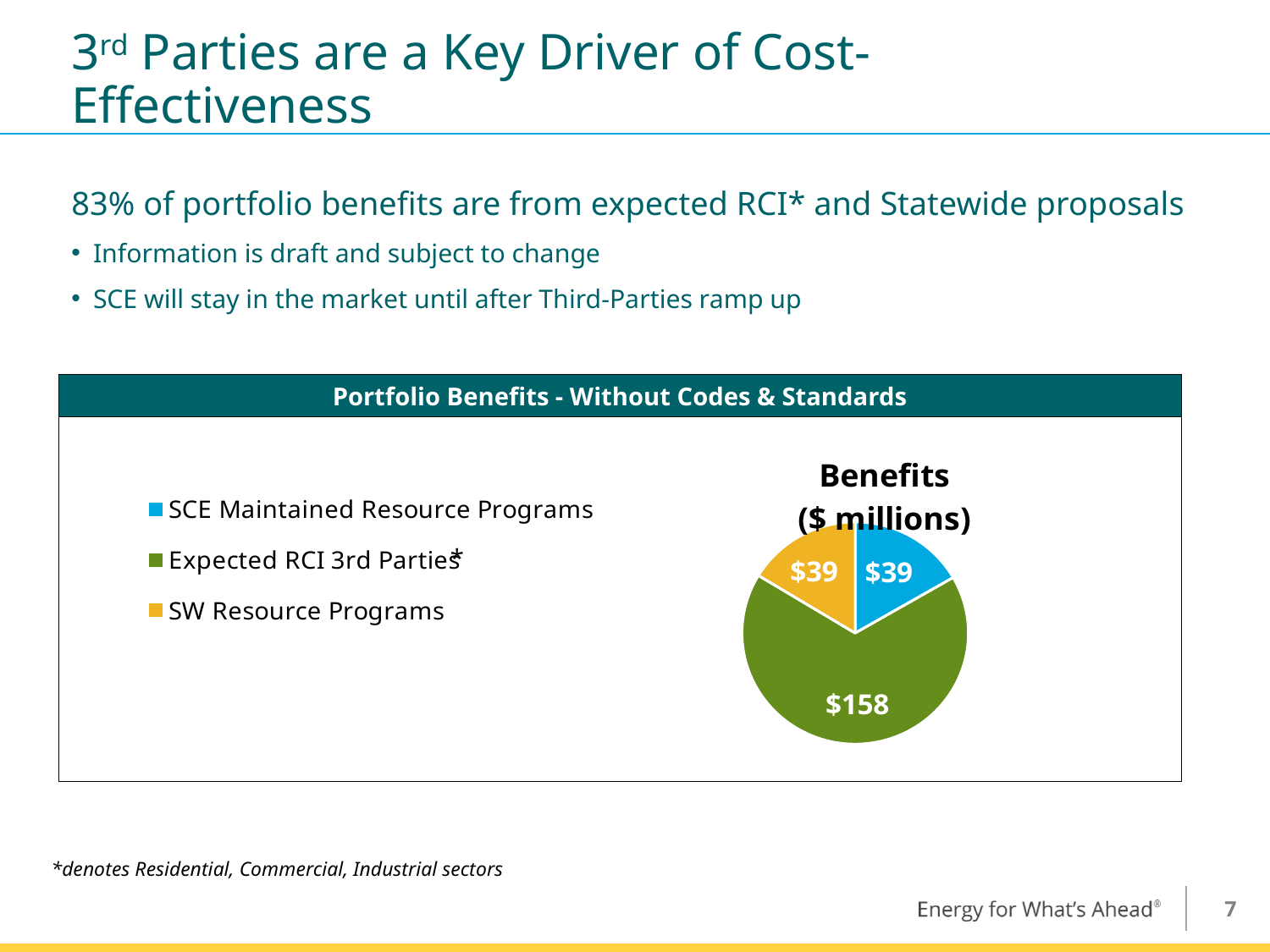
What is the difference between the Expected RCI 3rd Parties value and the SCE Maintained Resource Programs value? $119 What is the value for SW Resource Programs in the pie chart? $39 What is the title of the pie chart? Benefits ($ millions) What is the value for Expected RCI 3rd Parties in the Benefits ($ millions) pie chart? $158 What kind of chart is shown on the slide? Pie chart How many slices does the Benefits ($ millions) pie chart have? 3 How many entries does the legend of the pie chart list? 3 Which category has the largest slice in the Benefits ($ millions) pie chart? Expected RCI 3rd Parties Which is larger, the value for Expected RCI 3rd Parties or the value for SW Resource Programs? Expected RCI 3rd Parties What is the value for SCE Maintained Resource Programs in the pie chart? $39 What is the total of all slices in the Benefits ($ millions) pie chart? $236 What colour is the Expected RCI 3rd Parties slice in the pie chart? Green